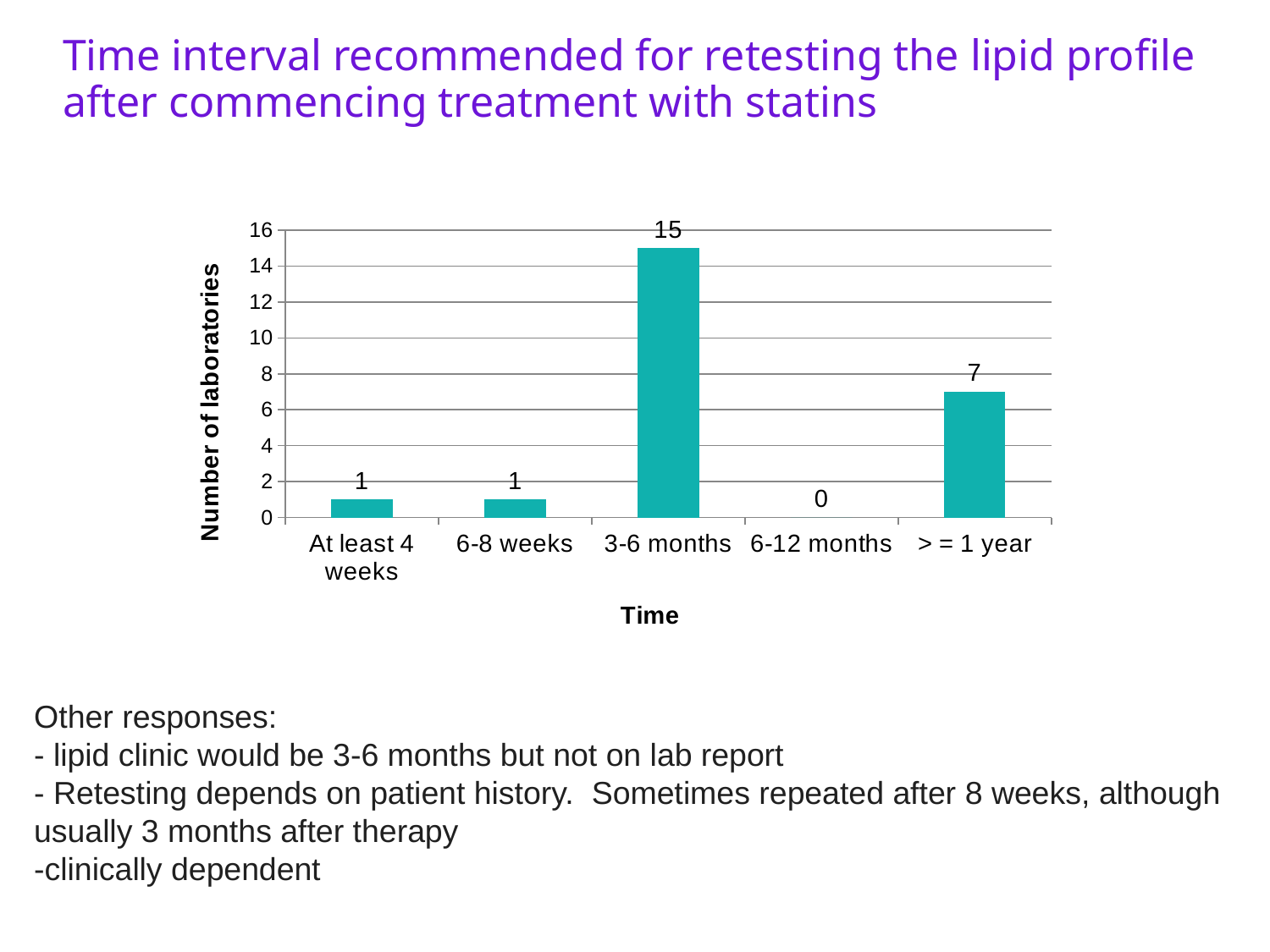
Which time interval has the lowest number of laboratories? 6-12 months What is the label of the y axis? Number of laboratories Which has more laboratories, 6-8 weeks or > = 1 year? > = 1 year What type of chart is shown on the slide? bar chart What is the number of laboratories for the '> = 1 year' category? 7 What is the difference between the number of laboratories for 3-6 months and for > = 1 year? 8 Is the value for 3-6 months greater or less than 10? greater What is the value for 'At least 4 weeks'? 1 How many laboratories recommended retesting at 3-6 months? 15 How many laboratories recommended retesting at 6-12 months? 0 How many time interval categories are shown on the x axis? 5 Which time interval has the highest number of laboratories? 3-6 months